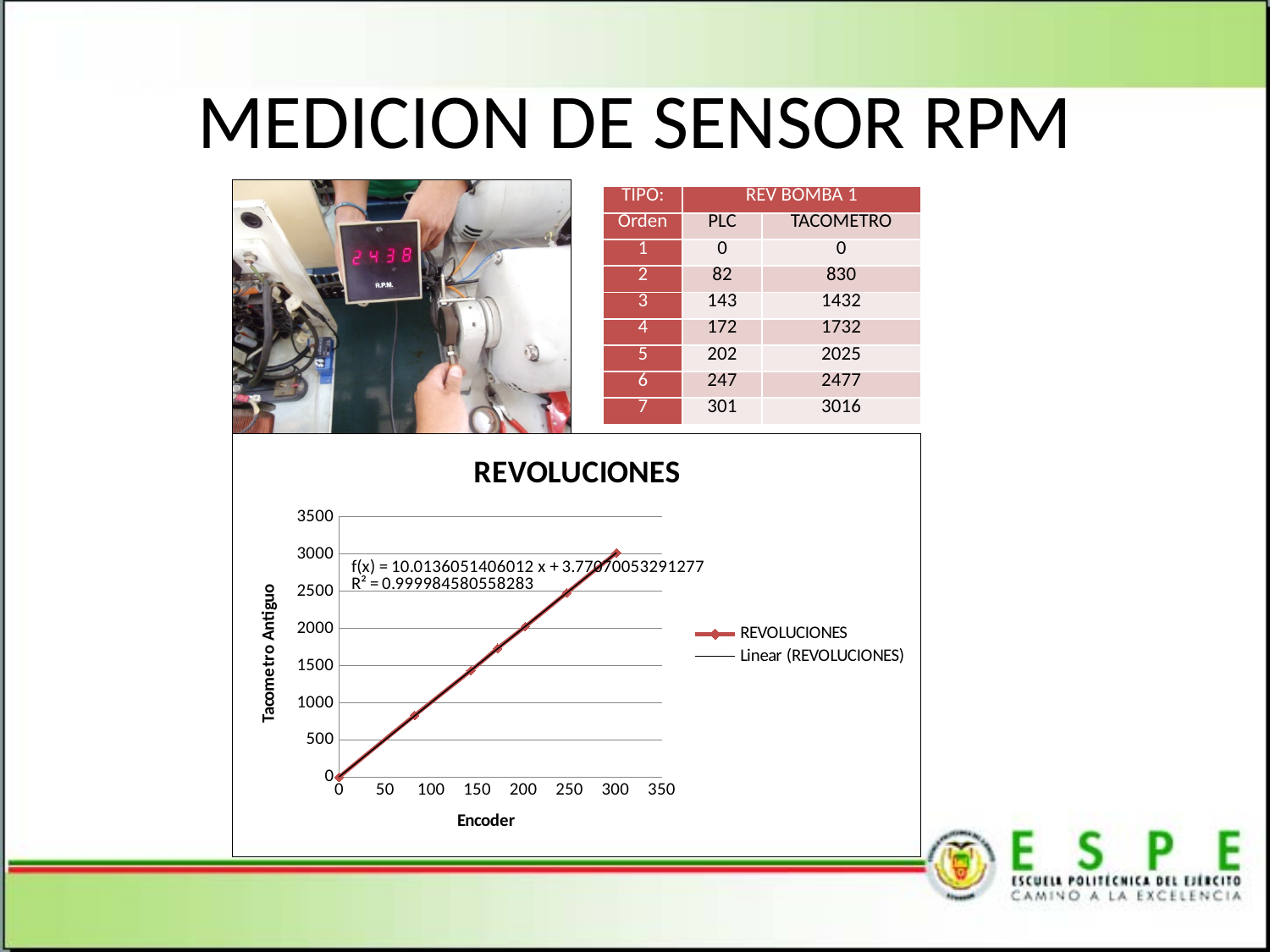
In the REVOLUCIONES chart, is the Tacometro Antiguo value at the point near Encoder 250 greater or less than 3000? less How many entries does the legend of the REVOLUCIONES chart list? 2 What kind of chart is shown under the title REVOLUCIONES? line chart According to the table, what is the TACOMETRO value for Orden 5, which is plotted in the REVOLUCIONES chart? 2025 According to the table, what is the highest TACOMETRO value plotted in the REVOLUCIONES chart? 3016 How many data points are plotted in the REVOLUCIONES chart? 7 In the REVOLUCIONES chart, is the Tacometro Antiguo value at the point near Encoder 200 greater or less than 1500? greater What is the label of the vertical axis of the REVOLUCIONES chart? Tacometro Antiguo What is the title of the chart? REVOLUCIONES Do the values in the REVOLUCIONES chart rise or fall as Encoder increases? rise In the REVOLUCIONES chart, is the Tacometro Antiguo value at the point near Encoder 80 greater or less than 1000? less